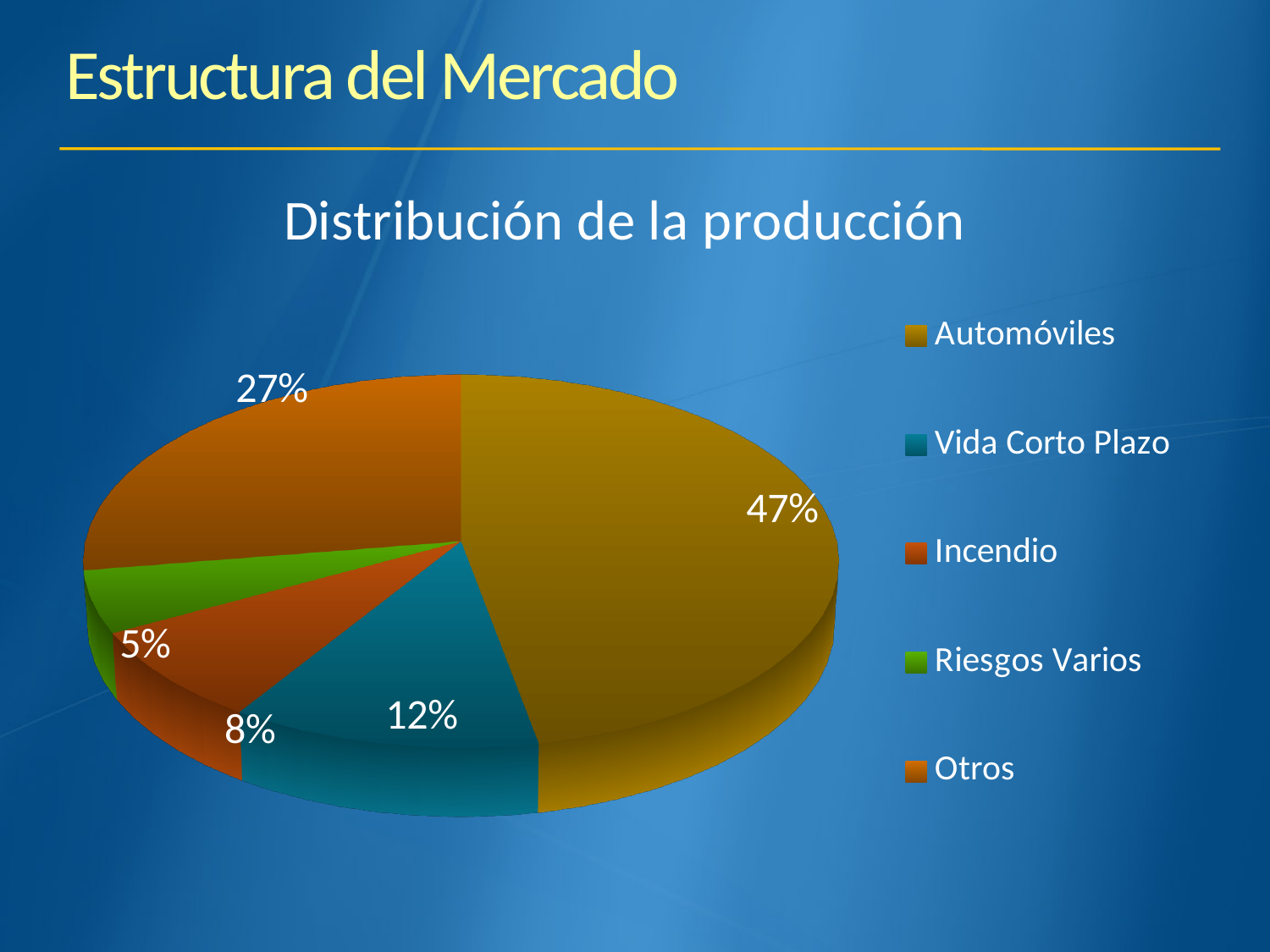
What is the difference in percentage points between Automóviles and Otros? 20 What share of the pie does Incendio hold? 8% Which category has the largest slice of the pie? Automóviles What share of the pie does Riesgos Varios hold? 5% What kind of chart is shown on the slide? Pie chart What share of the pie does Vida Corto Plazo hold? 12% What is the chart's title? Distribución de la producción Which is larger, the share for Vida Corto Plazo or the share for Incendio? Vida Corto Plazo What share of the pie does Automóviles hold? 47% How many categories does the legend list? 5 Which category has the smallest slice of the pie? Riesgos Varios What share of the pie does Otros hold? 27%